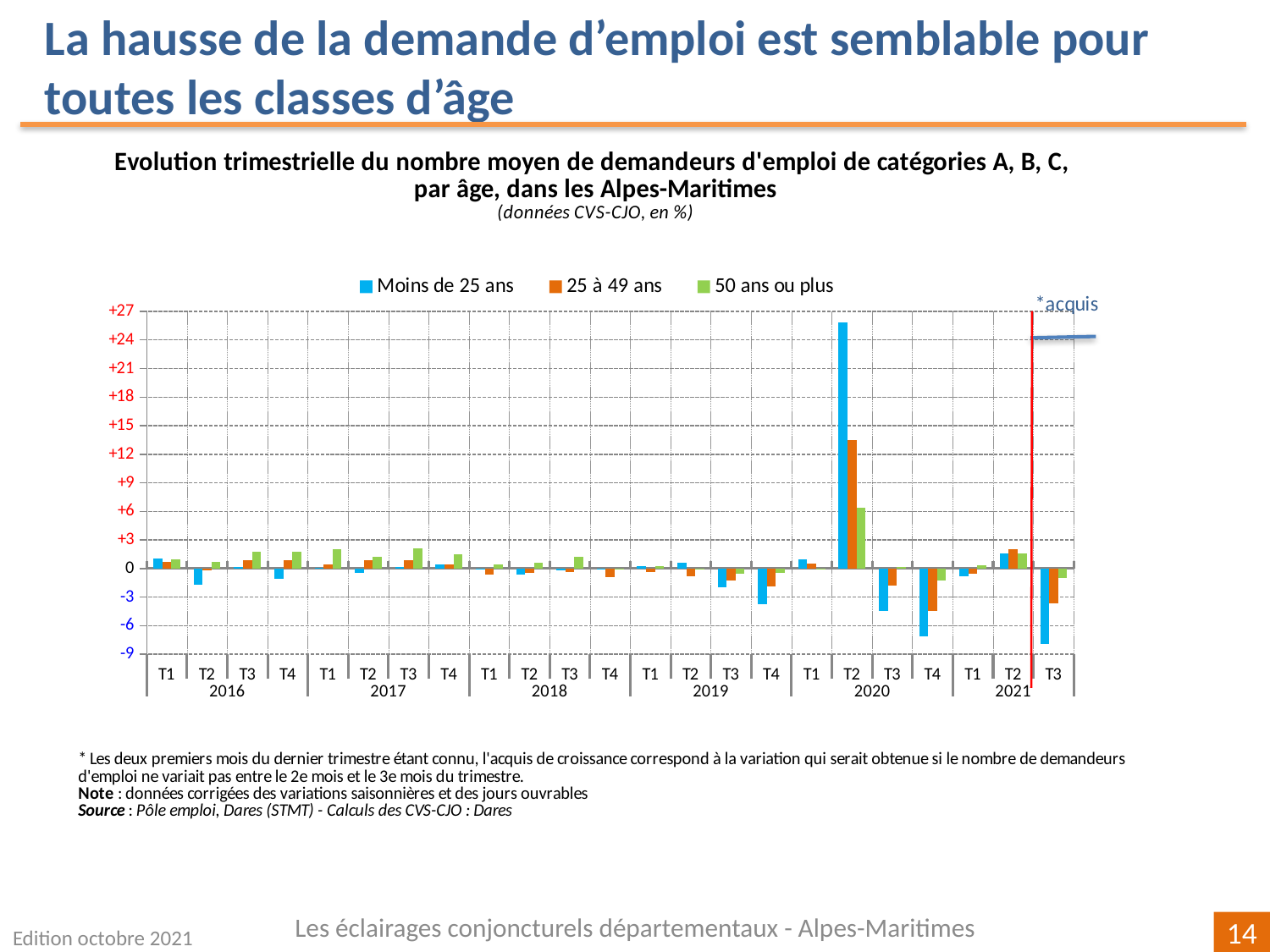
Is the value for 'Moins de 25 ans' in T2 2020 greater or less than +21? greater In T4 2020, which series has the lower value: 'Moins de 25 ans' or '50 ans ou plus'? Moins de 25 ans Is the value for '25 à 49 ans' in T2 2020 greater or less than +12? greater Is the value for '50 ans ou plus' in T2 2020 greater or less than +3? greater Which series is shown in blue in the legend? Moins de 25 ans What label is written next to the red vertical line at the right of the chart? *acquis How many quarters (bar groups) are plotted along the x axis? 23 What kind of chart is shown on the slide? bar chart In which quarter does the 'Moins de 25 ans' series reach its highest value? T2 2020 How many series does the legend list? 3 In T2 2020, which series has the larger value: 'Moins de 25 ans' or '25 à 49 ans'? Moins de 25 ans